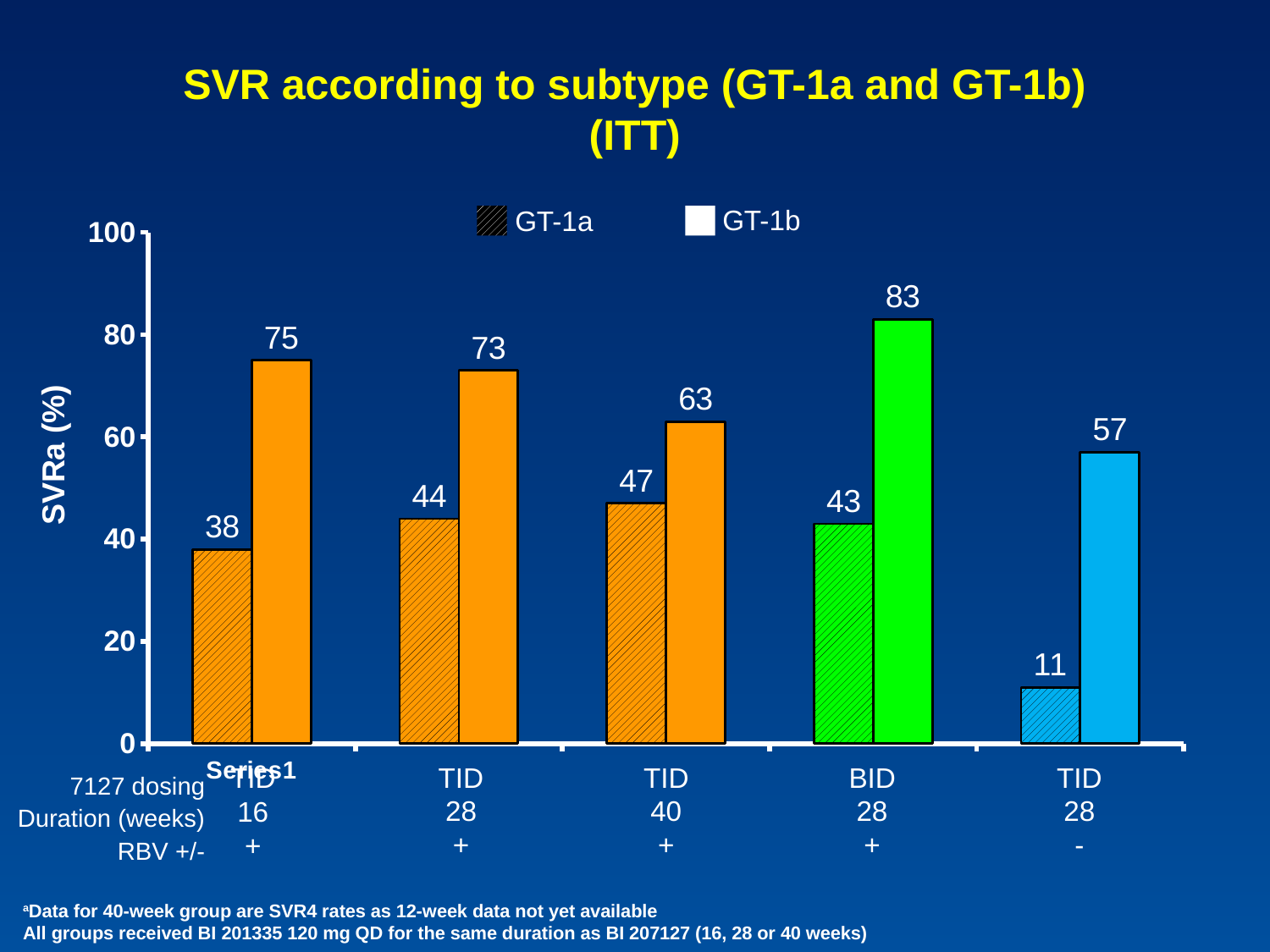
Which group has the highest GT-1b SVR value? BID 28 weeks with RBV How many dosing groups are shown on the x axis? 5 What is the difference between the GT-1b values of the BID 28-week group with RBV and the TID 28-week group without RBV? 26 What is the GT-1b SVR value for the BID 28-week group with RBV? 83 What is the GT-1a SVR value for the TID 16-week group with RBV? 38 How many series does the legend list? 2 What is the label of the y axis? SVRa (%) Which group has the lowest GT-1a SVR value? TID 28 weeks without RBV Which is larger in the TID 40-week group: the GT-1a value or the GT-1b value? GT-1b What kind of chart is shown on the slide? Bar chart What is the GT-1a SVR value for the TID 28-week group without RBV? 11 What is the difference between the GT-1b and GT-1a SVR values in the TID 16-week group with RBV? 37